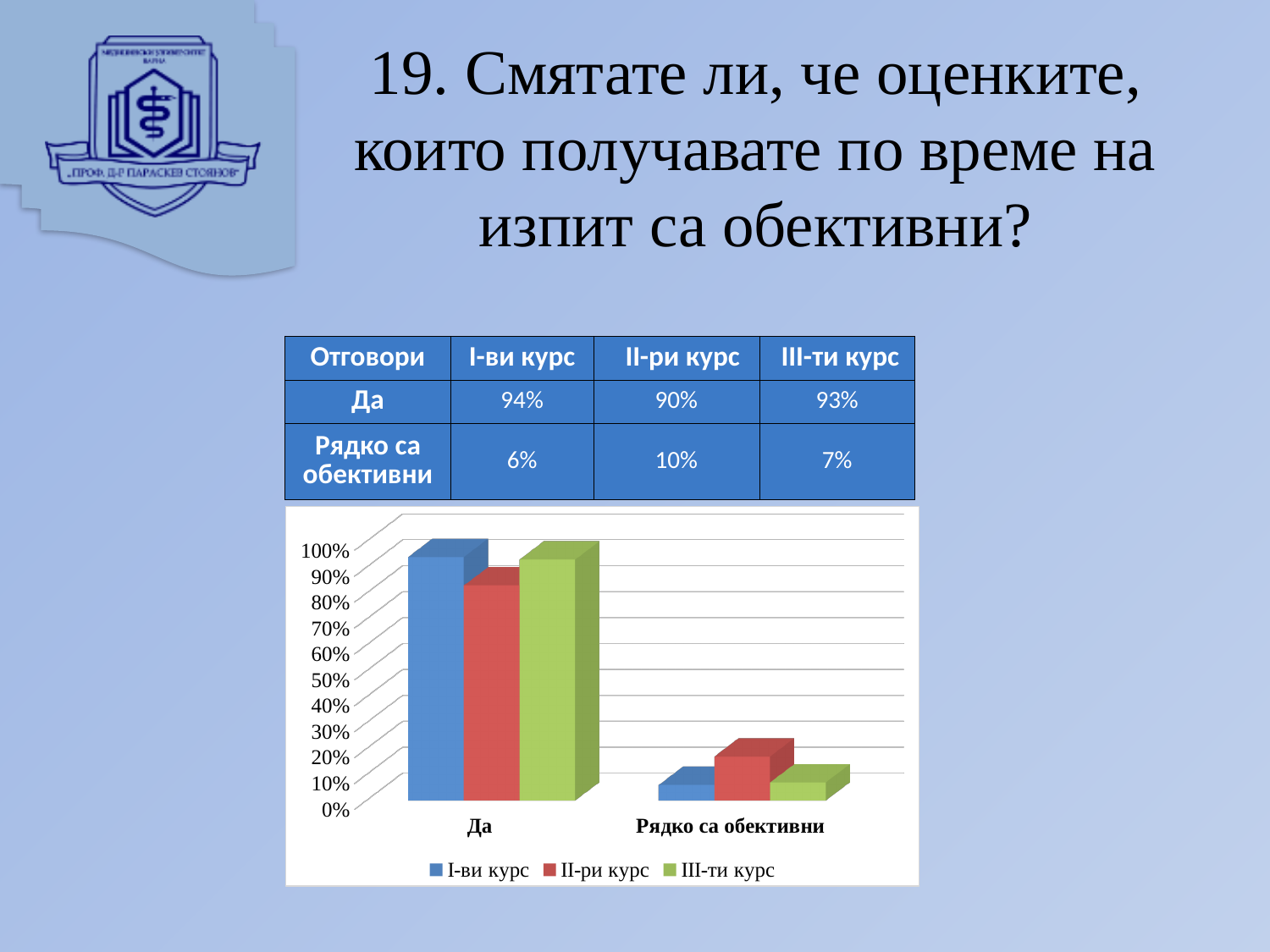
How many categories are shown on the x axis of the chart? 2 What is the value for III-ти курс in the category Да? 93% Which series has the lowest value in the category Да? II-ри курс What is the value for I-ви курс in the category Да? 94% How many series does the chart legend list? 3 Which is larger: the II-ри курс value or the I-ви курс value in the category Рядко са обективни? II-ри курс Which series has the highest value in the category Рядко са обективни? II-ри курс Is the value for III-ти курс in the category Рядко са обективни greater or less than 20%? less What kind of chart is shown on the slide? bar chart Which colour represents II-ри курс in the chart legend? red